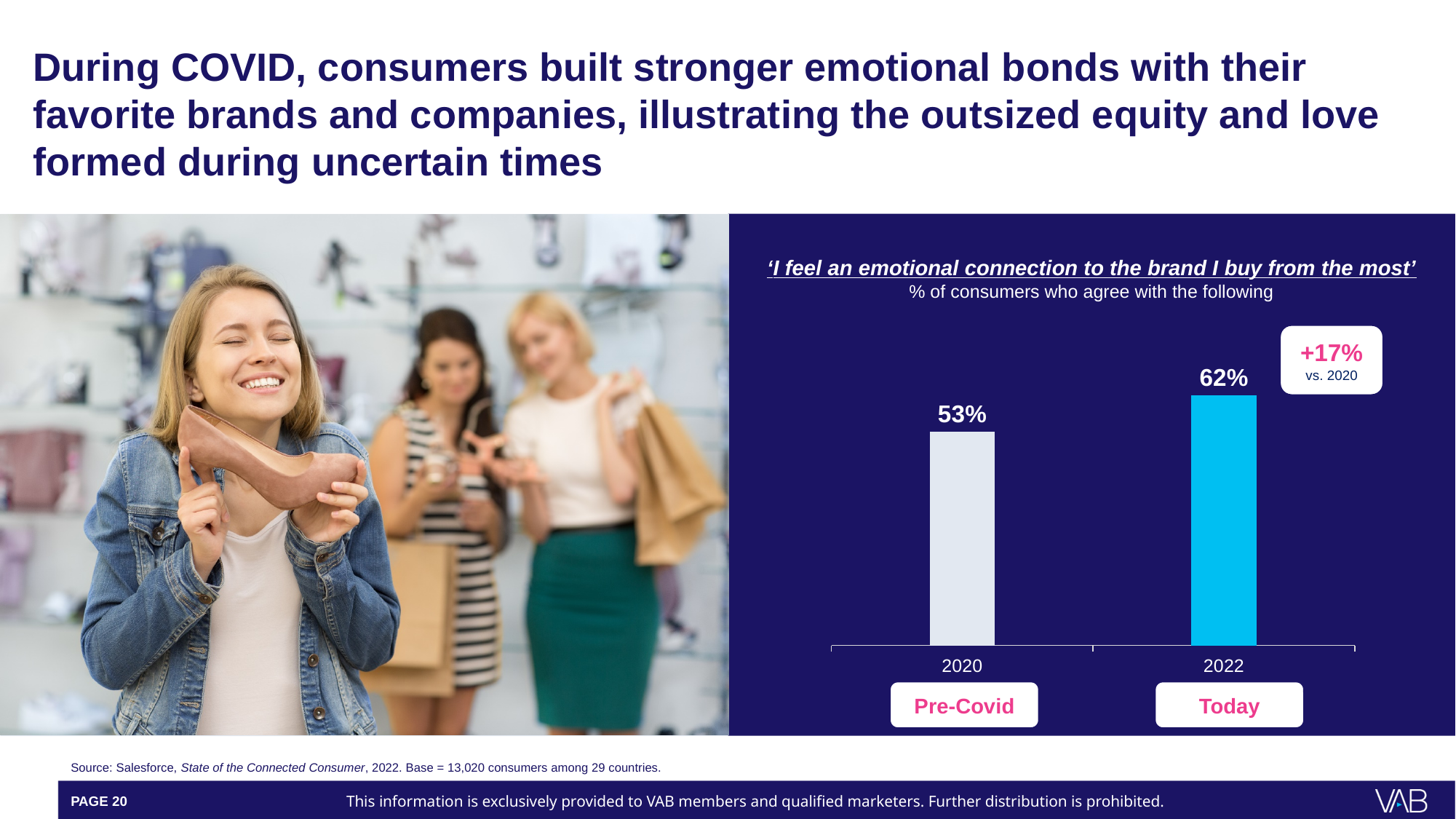
Do the values rise or fall from 2020 to 2022? rise What label is shown beneath the 2020 bar? Pre-Covid By how many percentage points did agreement with the statement increase from 2020 to 2022? 9 percentage points Which year has the lower share of consumers agreeing with the statement? 2020 What kind of chart is shown on the slide? Bar chart What percentage of consumers agreed with 'I feel an emotional connection to the brand I buy from the most' in 2020? 53% What percentage of consumers agreed with 'I feel an emotional connection to the brand I buy from the most' in 2022? 62% What percentage change versus 2020 is called out in the box next to the 2022 bar? +17% Which year has the higher share of consumers agreeing with the statement, 2020 or 2022? 2022 Is the value for 2022 larger or smaller than the value for 2020? larger How many bars are shown in the chart? 2